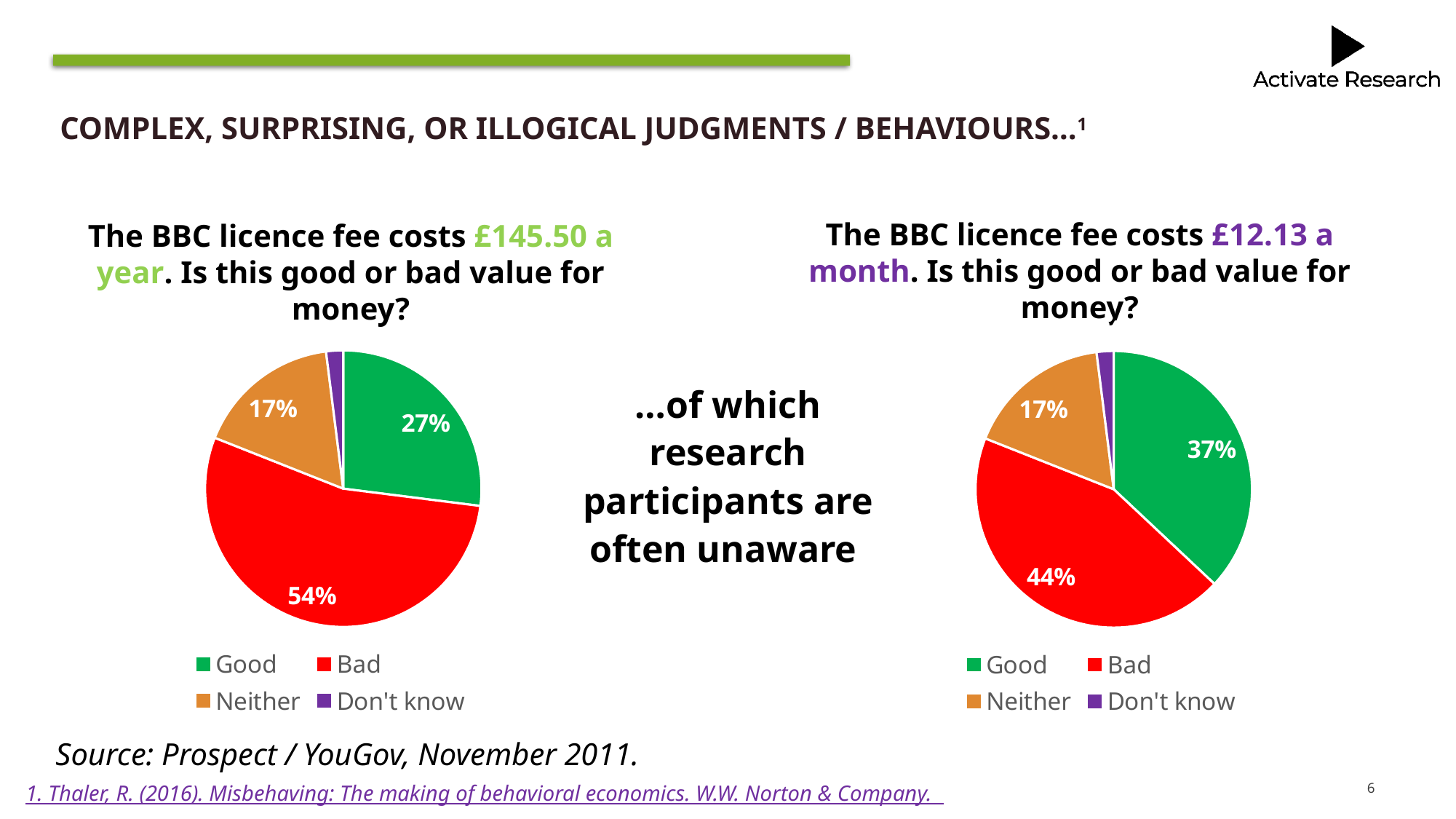
In the left pie chart (£145.50 a year), what share of respondents said the licence fee is bad value for money? 54% In the left pie chart (£145.50 a year), what is the difference between the Bad and Good shares? 27% In the right pie chart (£12.13 a month), what share of respondents said the licence fee is bad value for money? 44% In the right pie chart (£12.13 a month), what share of respondents answered Neither? 17% What type of chart is used on this slide? Pie chart How many categories does the legend of the left pie chart list? 4 In the right pie chart (£12.13 a month), what colour represents the Bad response? Red In the left pie chart (£145.50 a year), what share of respondents said the licence fee is good value for money? 27% In the left pie chart (£145.50 a year), which response has the largest share? Bad In the right pie chart (£12.13 a month), which response has the smallest share? Don't know Which chart shows a larger share for Good: the left chart (£145.50 a year) or the right chart (£12.13 a month)? The right chart (£12.13 a month) In the right pie chart (£12.13 a month), what share of respondents said the licence fee is good value for money? 37%